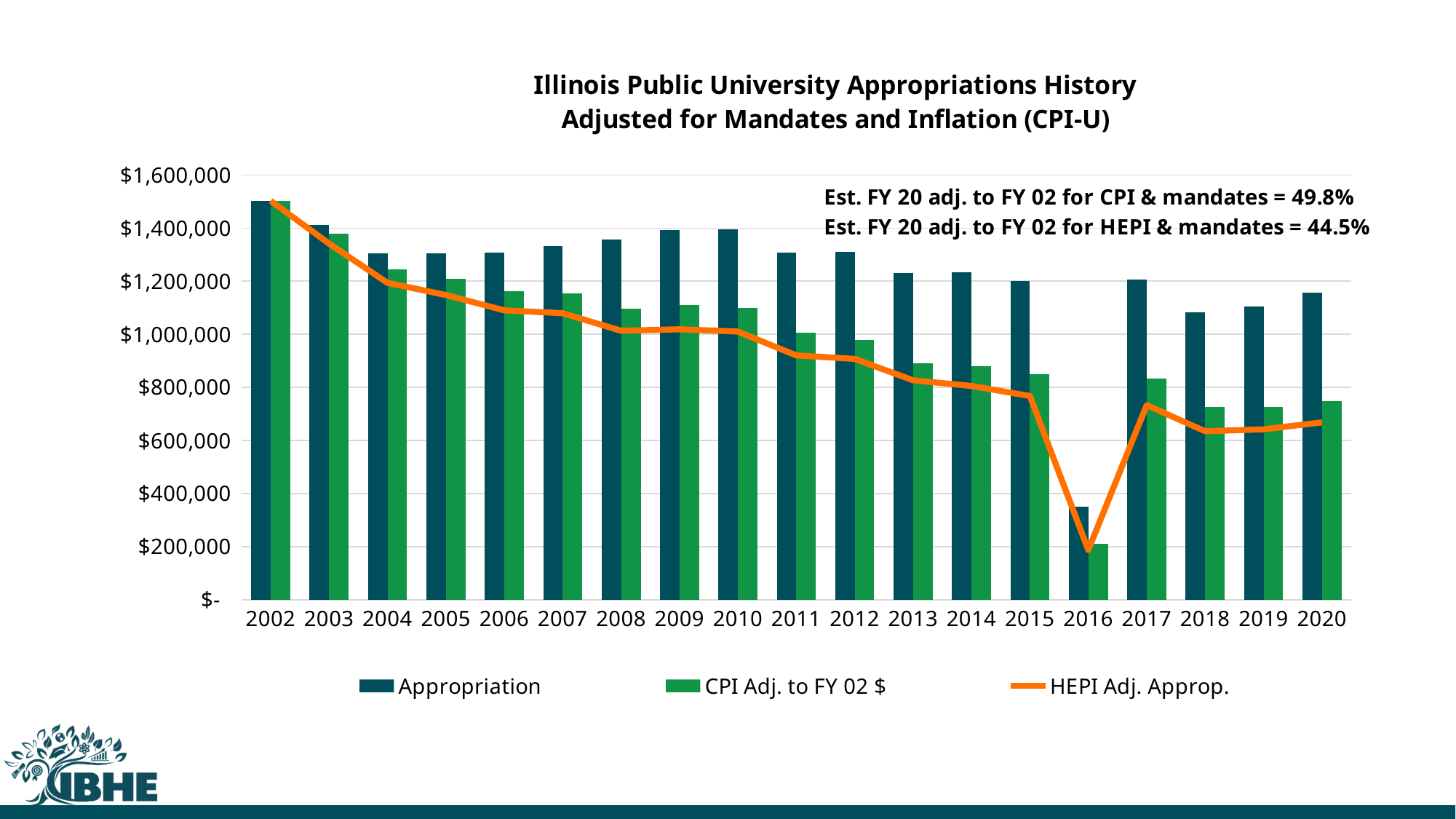
In which year is the CPI Adj. to FY 02 $ bar the lowest? 2016 How many series does the legend list? 3 According to the annotation on the chart, what is the estimated FY 20 adjusted to FY 02 for CPI & mandates? 49.8% Is the Appropriation value for 2018 greater or less than $1,000,000? greater Does the CPI Adj. to FY 02 $ series rise or fall from 2002 to 2015? fall Is the Appropriation value for 2016 greater or less than $400,000? less In which year is the Appropriation bar the lowest? 2016 Is the CPI Adj. to FY 02 $ value for 2020 greater or less than $600,000? greater How many years are shown on the x axis? 19 What kind of chart is shown on the slide? bar chart with a line Which year has the larger Appropriation bar, 2017 or 2018? 2017 In which year is the Appropriation bar the highest? 2002